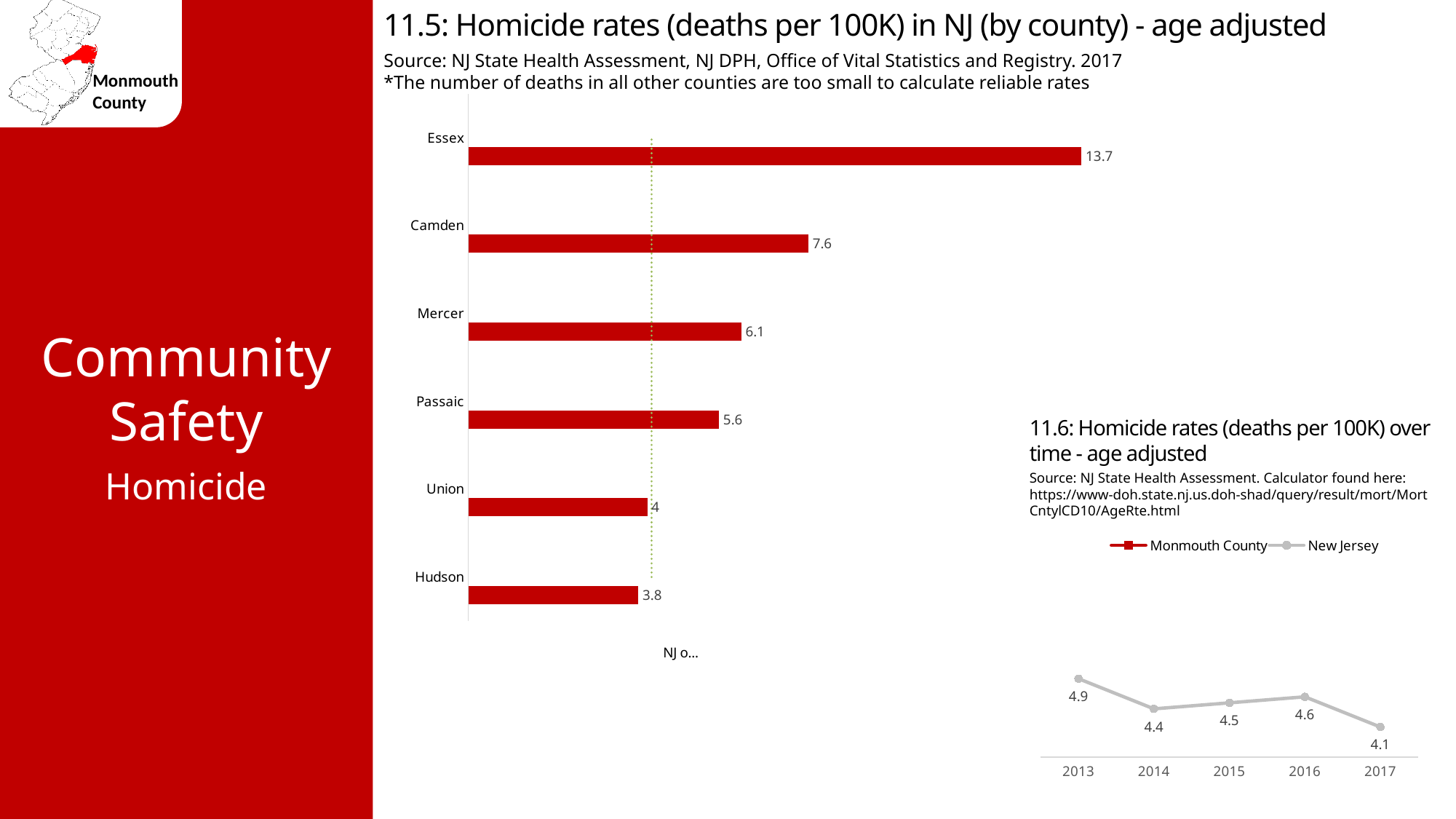
In chart 11.5, which county has the highest homicide rate? Essex In chart 11.6, what is the New Jersey homicide rate in 2017? 4.1 In chart 11.6, what is the New Jersey homicide rate in 2013? 4.9 How many series does the legend of chart 11.6 list? 2 In chart 11.5, which county has the lowest homicide rate? Hudson In chart 11.5, what is the homicide rate for Passaic? 5.6 In chart 11.6, which year has the lowest New Jersey homicide rate? 2017 In chart 11.5, what is the homicide rate for Essex? 13.7 What kind of chart is chart 11.5? Bar chart In chart 11.5, which county has a higher homicide rate, Mercer or Union? Mercer In chart 11.5, how many counties are shown? 6 In chart 11.5, what is the difference between the homicide rates of Essex and Camden? 6.1